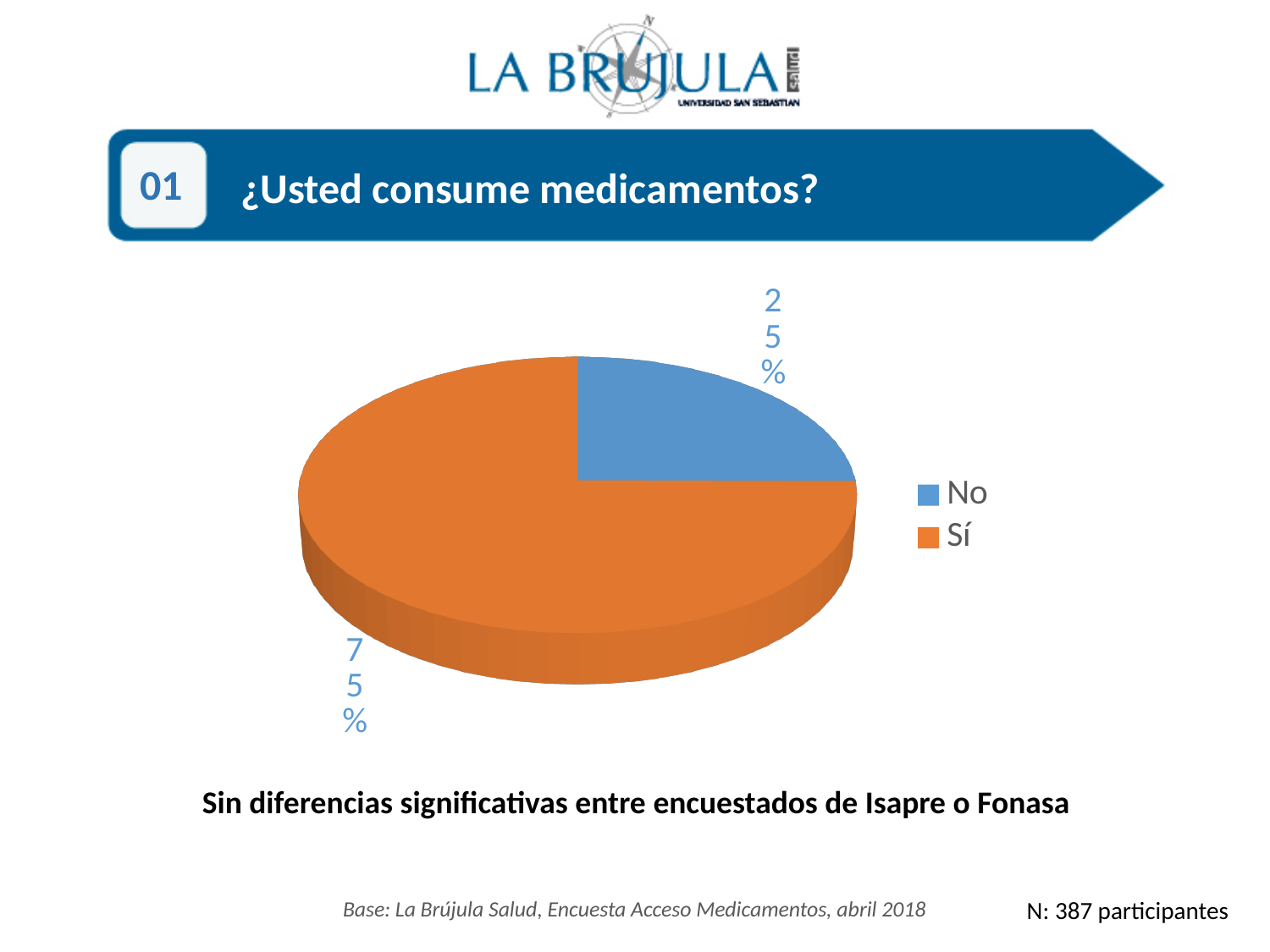
How many categories does the pie chart have? 2 What colour is the "No" slice? blue How many entries does the legend list? 2 What percentage of respondents answered "Sí"? 75% Which category has the smallest share of the pie? No What percentage of respondents answered "No"? 25% What colour is the "Sí" slice? orange What is the difference in percentage points between "Sí" and "No"? 50 Which category has the largest share of the pie? Sí What share of the pie does the "No" slice represent? 25% Which is larger, the share for "Sí" or the share for "No"? Sí What kind of chart is shown on the slide? pie chart